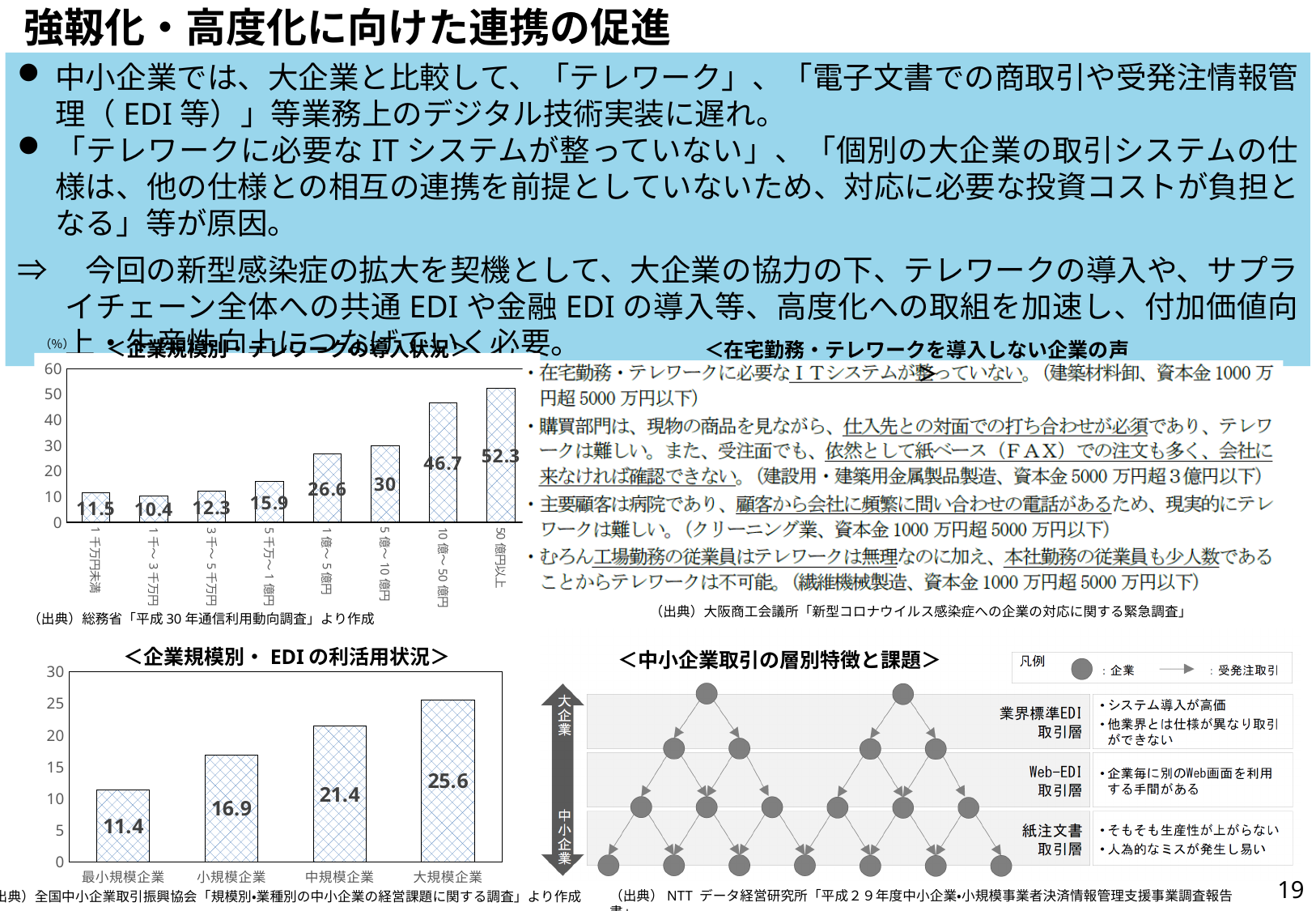
What kind of chart is the bottom-left chart titled ＜企業規模別・EDIの利活用状況＞? bar chart In the top-left chart on telework adoption by company size (テレワークの導入状況), which category has the lowest value? 1千～3千万円 In the bottom-left chart titled ＜企業規模別・EDIの利活用状況＞, how many categories are shown? 4 In the top-left chart on telework adoption by company size (テレワークの導入状況), how many categories are shown? 8 In the top-left chart on telework adoption by company size (テレワークの導入状況), what is the value for 50億円以上? 52.3 In the top-left chart on telework adoption by company size (テレワークの導入状況), what is the value for 1億～5億円? 26.6 In the bottom-left chart titled ＜企業規模別・EDIの利活用状況＞, which category has the lowest value? 最小規模企業 In the bottom-left chart titled ＜企業規模別・EDIの利活用状況＞, what is the value for 大規模企業? 25.6 In the top-left chart on telework adoption by company size (テレワークの導入状況), what is the difference between 10億～50億円 and 5億～10億円? 16.7 In the bottom-left chart titled ＜企業規模別・EDIの利活用状況＞, what is the value for 最小規模企業? 11.4 In the bottom-left chart titled ＜企業規模別・EDIの利活用状況＞, what is the difference between 中規模企業 and 小規模企業? 4.5 In the bottom-left chart titled ＜企業規模別・EDIの利活用状況＞, do the values rise or fall from left to right? rise